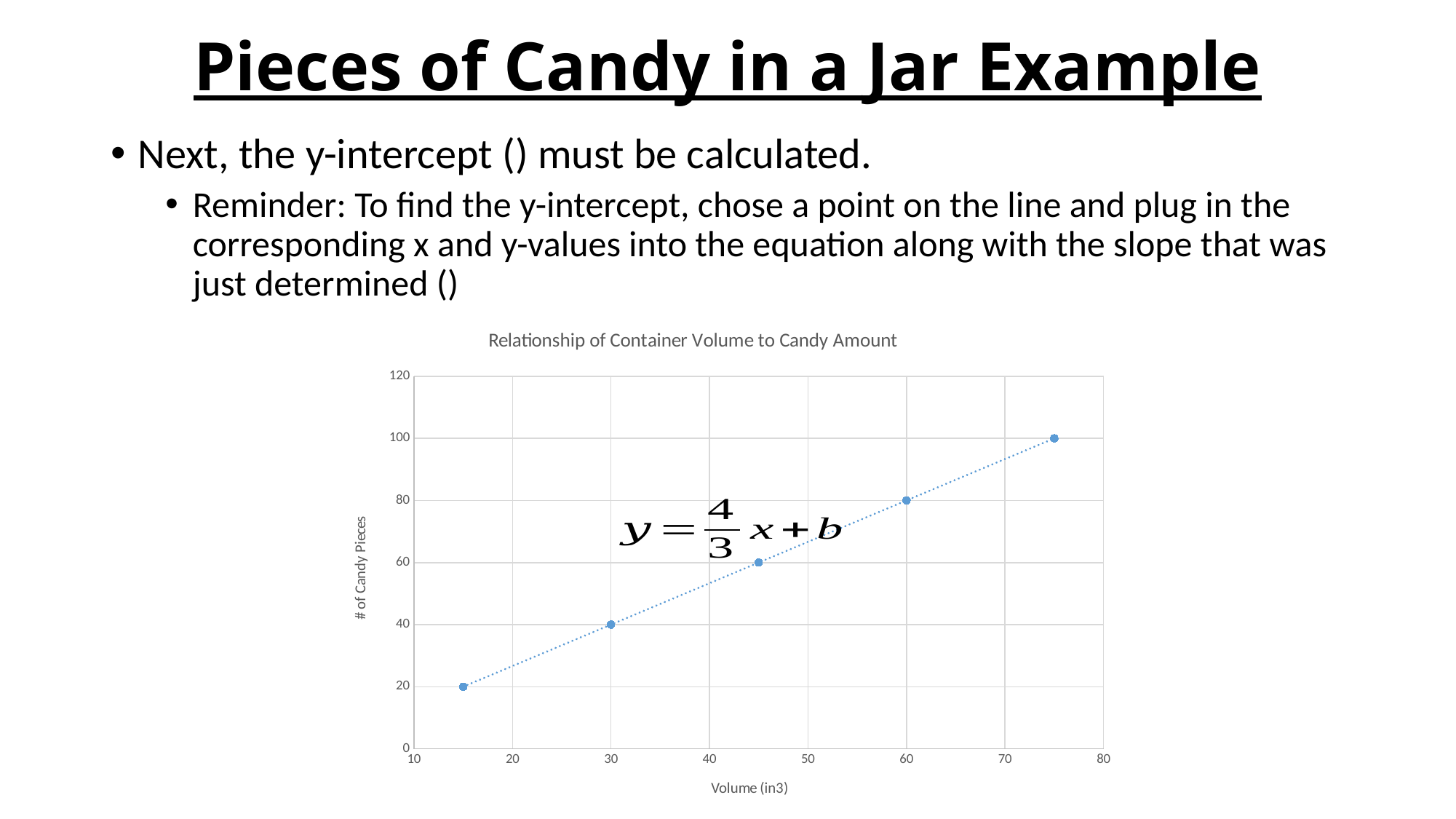
What type of chart is shown on the slide? scatter plot Do the number of candy pieces rise or fall as volume increases? rise What is the number of candy pieces at a volume of 60 in3? 80 What is the label of the x-axis? Volume (in3) How many data points are plotted on the chart? 5 Is the number of candy pieces at a volume of 60 in3 greater or less than 60? greater What is the number of candy pieces at a volume of 30 in3? 40 What is the y-value of the lowest plotted point? 20 What is the difference in candy pieces between the points at volumes 60 in3 and 30 in3? 40 What is the title of the chart? Relationship of Container Volume to Candy Amount Which has more candy pieces: the point at volume 30 in3 or the point at volume 60 in3? 60 in3 What is the y-value of the highest plotted point? 100